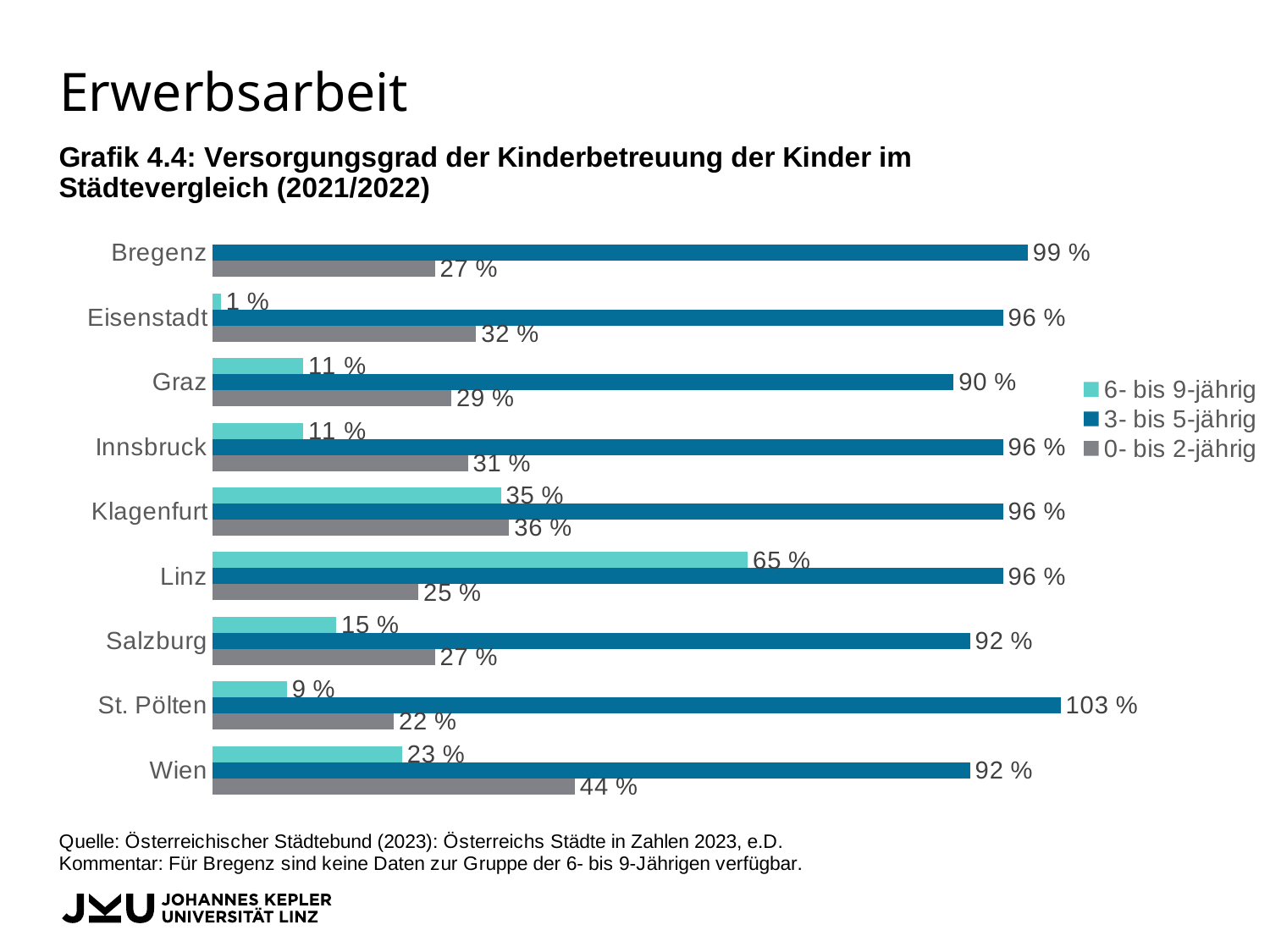
What is the value for Wien in the 0- bis 2-jährig series? 44 % Which city has the lowest value in the 0- bis 2-jährig series? St. Pölten What is the value for St. Pölten in the 3- bis 5-jährig series? 103 % What is the value for Linz in the 6- bis 9-jährig series? 65 % How many series does the legend list? 3 What is the difference between the 3- bis 5-jährig value and the 0- bis 2-jährig value for Bregenz? 72 % Which city has no bar for the 6- bis 9-jährig series? Bregenz Which city has the highest value in the 3- bis 5-jährig series? St. Pölten Which city has the lowest value in the 6- bis 9-jährig series? Eisenstadt What kind of chart is shown on the slide? Bar chart How many cities are shown on the chart? 9 Which is larger for Klagenfurt: the 6- bis 9-jährig value or the 0- bis 2-jährig value? 0- bis 2-jährig